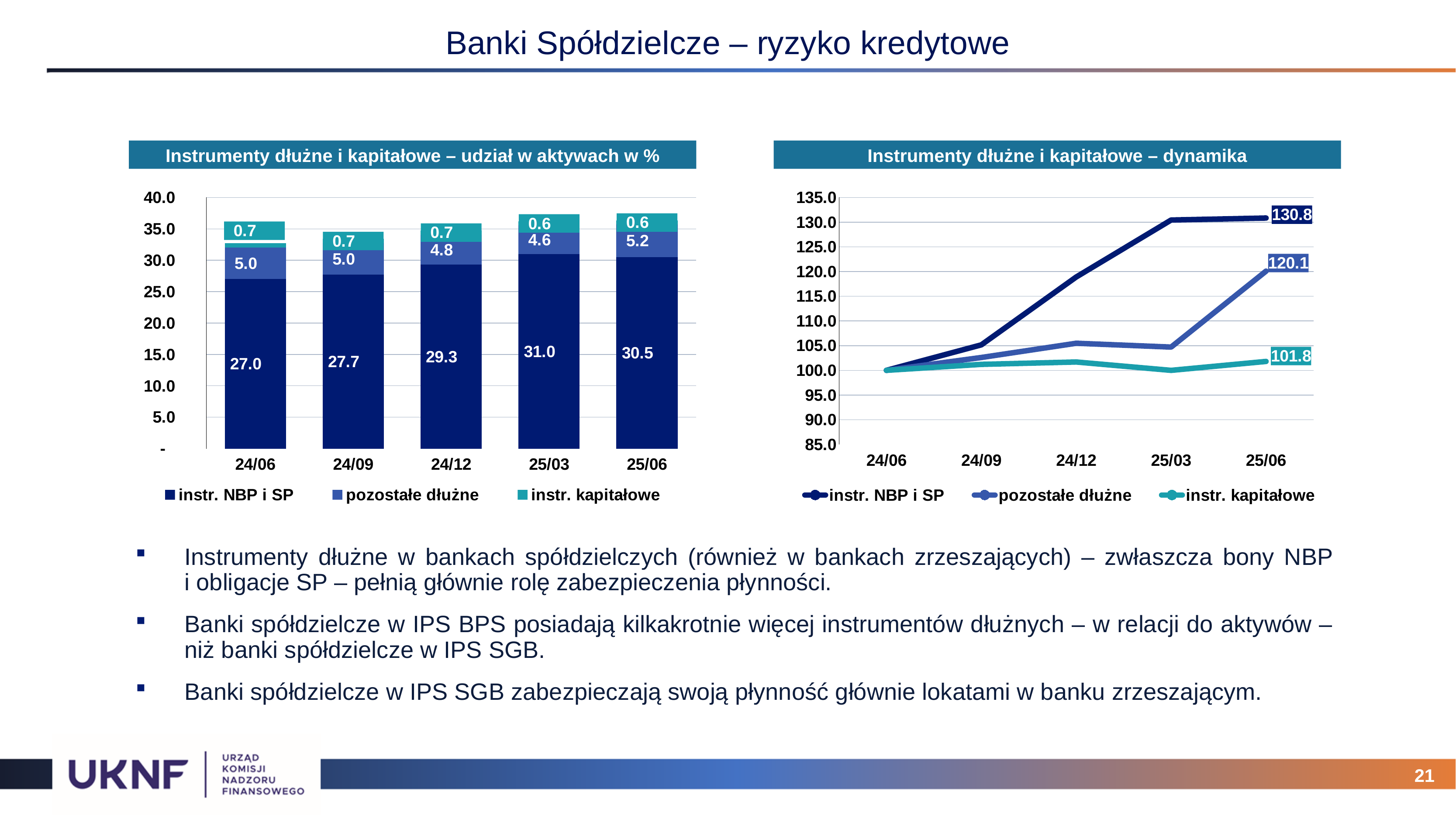
In the chart 'Instrumenty dłużne i kapitałowe – udział w aktywach w %', how many periods are shown on the x axis? 5 In the chart 'Instrumenty dłużne i kapitałowe – udział w aktywach w %', which period has the highest value for 'instr. NBP i SP'? 25/03 In the chart 'Instrumenty dłużne i kapitałowe – udział w aktywach w %', what is the value of 'pozostałe dłużne' for 25/06? 5.2 In the chart 'Instrumenty dłużne i kapitałowe – dynamika', is the value of 'pozostałe dłużne' for 25/03 greater or less than 110.0? less In the chart 'Instrumenty dłużne i kapitałowe – udział w aktywach w %', what is the value of 'instr. NBP i SP' for 25/03? 31.0 In the chart 'Instrumenty dłużne i kapitałowe – udział w aktywach w %', what is the difference between the 'instr. NBP i SP' values for 25/03 and 24/06? 4.0 In the chart 'Instrumenty dłużne i kapitałowe – udział w aktywach w %', what is the value of 'instr. kapitałowe' for 24/12? 0.7 In the chart 'Instrumenty dłużne i kapitałowe – dynamika', which series has the lowest value at 25/06? instr. kapitałowe In the chart 'Instrumenty dłużne i kapitałowe – dynamika', what is the value of 'instr. NBP i SP' for 25/06? 130.8 In the chart 'Instrumenty dłużne i kapitałowe – udział w aktywach w %', what is the total of the stacked bar for 25/06? 36.3 What type of chart is 'Instrumenty dłużne i kapitałowe – udział w aktywach w %'? Stacked bar chart In the chart 'Instrumenty dłużne i kapitałowe – udział w aktywach w %', which period has the lowest value for 'instr. NBP i SP'? 24/06